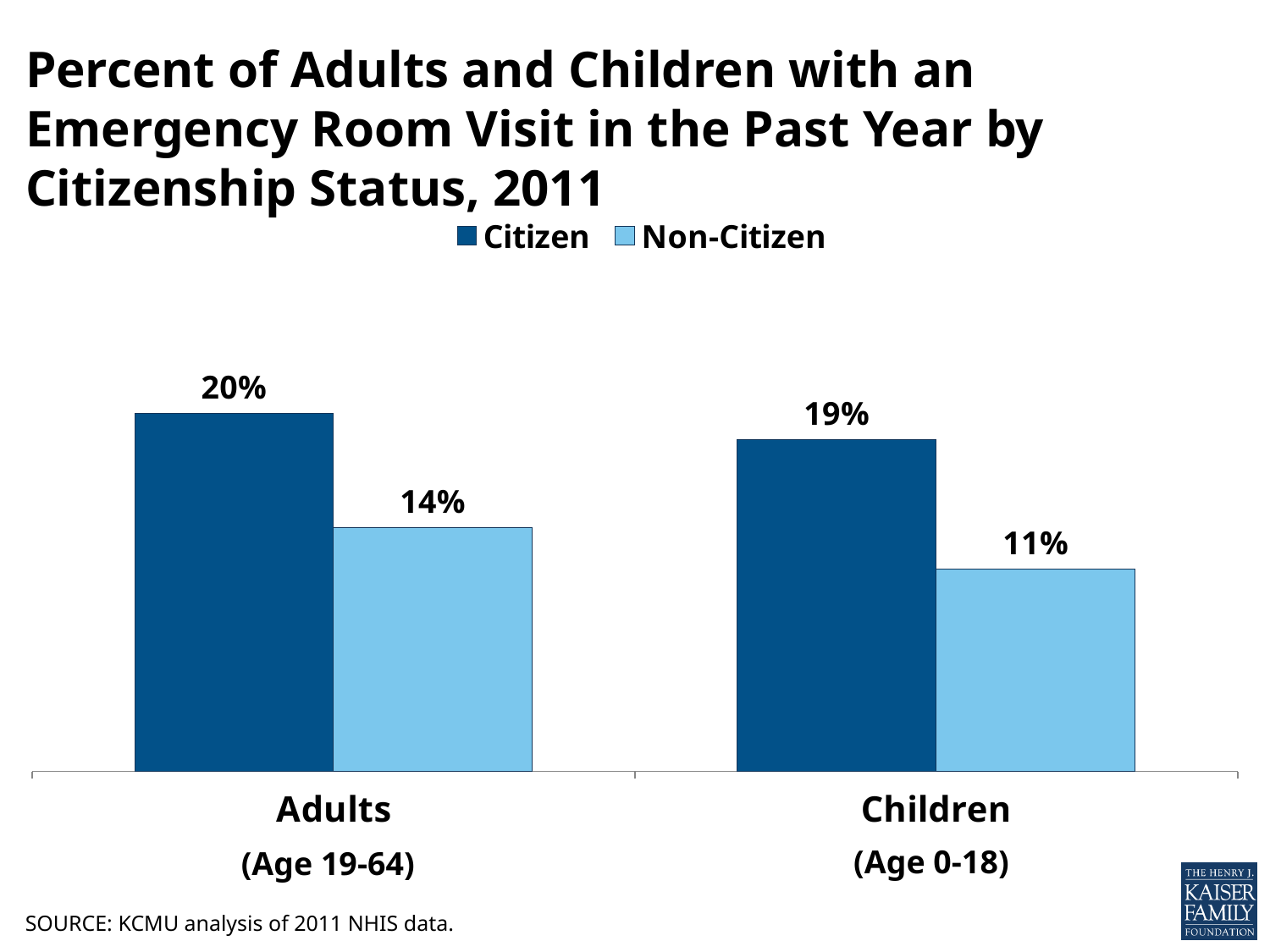
What is the difference in percentage points between citizen and non-citizen children? 8 percentage points What percent of non-citizen children (age 0-18) had an emergency room visit in the past year? 11% What percent of citizen adults (age 19-64) had an emergency room visit in the past year? 20% How many series does the legend list? 2 Which group has the highest percent with an emergency room visit? Citizen adults What kind of chart is shown on the slide? Bar chart What percent of non-citizen adults (age 19-64) had an emergency room visit in the past year? 14% What percent of citizen children (age 0-18) had an emergency room visit in the past year? 19% What is the difference in percentage points between citizen and non-citizen adults? 6 percentage points Which group has the lowest percent with an emergency room visit? Non-Citizen children Which is larger: the percent for non-citizen adults or non-citizen children? Non-citizen adults How many age-group categories are shown on the x axis? 2